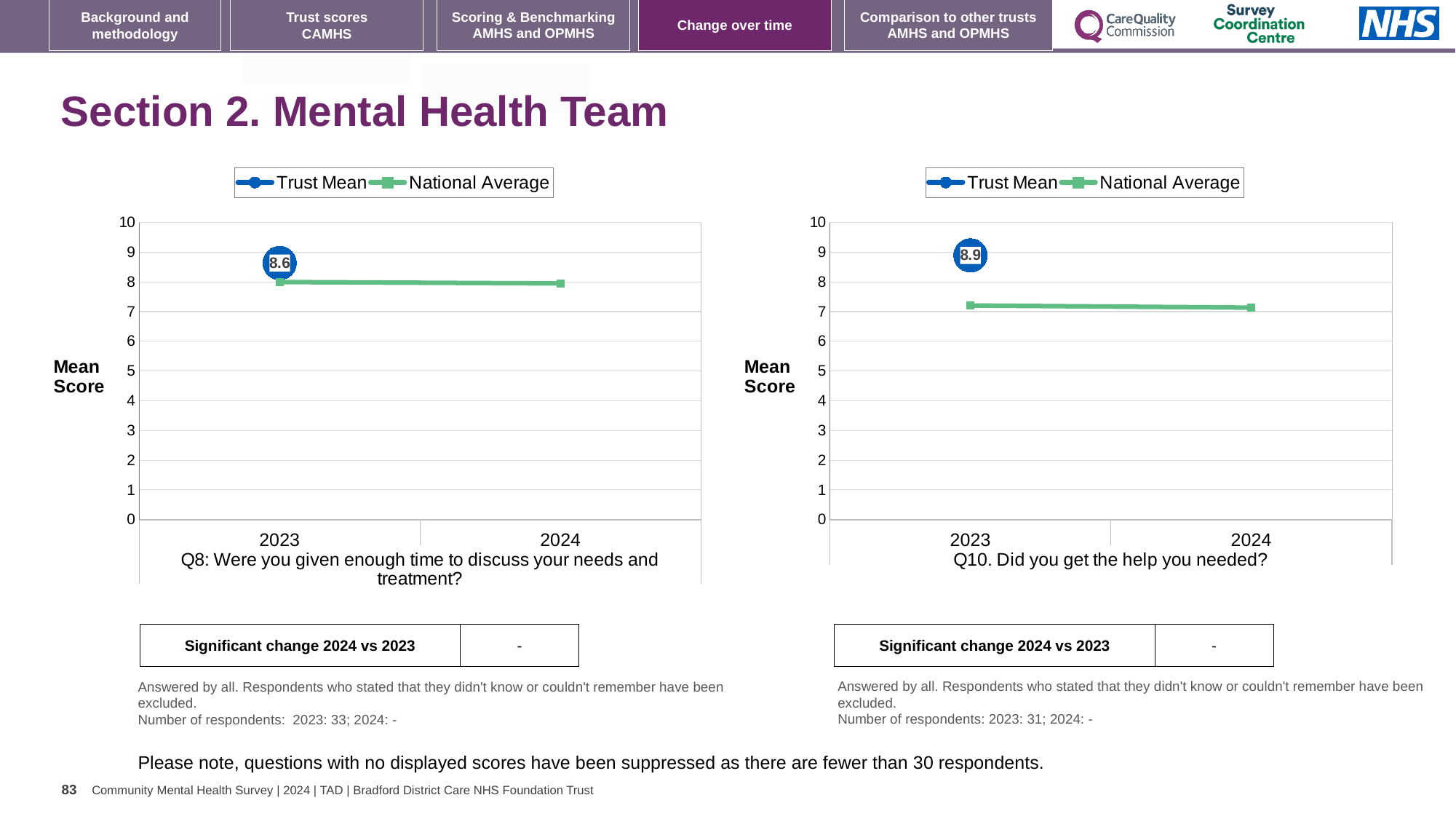
In the right chart (Q10), is the National Average for 2023 greater or less than 6? greater How many years are shown on the x axis of the left chart (Q8)? 2 In the right chart (Q10), which is larger in 2023, the Trust Mean or the National Average? Trust Mean What kind of chart is the right chart (Q10)? Line chart In the left chart (Q8), is the National Average for 2024 greater or less than 9? less In the right chart (Q10), what is the Trust Mean score for 2023? 8.9 In the right chart (Q10), is the National Average for 2024 greater or less than 8? less In the left chart (Q8), how many series does the legend list? 2 Which of the two charts has the higher Trust Mean score for 2023? The right chart (Q10) In the left chart (Q8), which is larger in 2023, the Trust Mean or the National Average? Trust Mean What is the question text shown beneath the x axis of the right chart? Q10. Did you get the help you needed? In the left chart (Q8), what is the Trust Mean score for 2023? 8.6